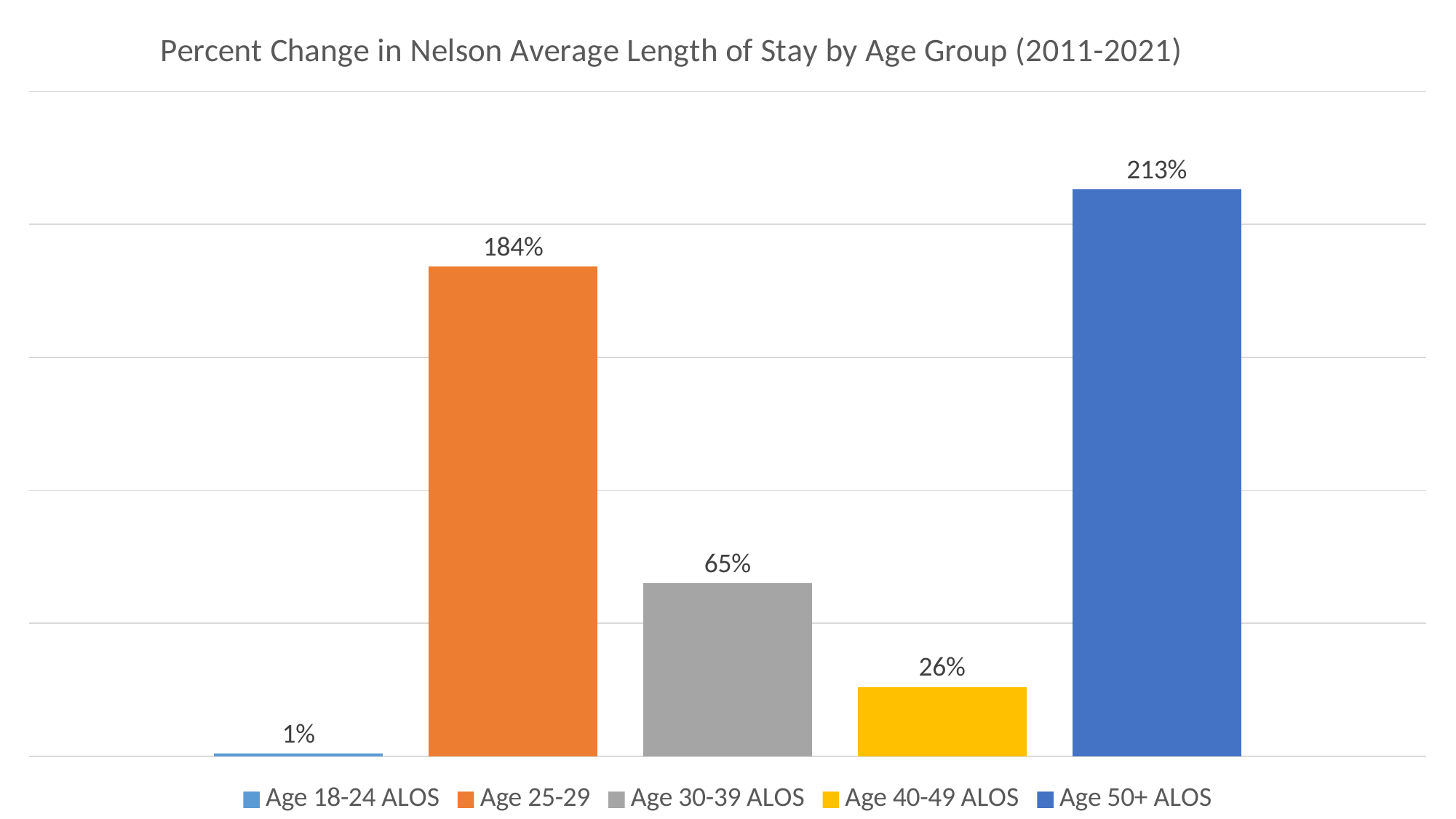
What is the title of the chart? Percent Change in Nelson Average Length of Stay by Age Group (2011-2021) How many age groups are shown in the chart? 5 What is the difference between the percent change for Age 30-39 ALOS and Age 40-49 ALOS? 39% What is the percent change in average length of stay for Age 25-29? 184% What is the difference between the percent change for Age 50+ ALOS and Age 25-29? 29% What is the percent change in average length of stay for Age 50+ ALOS? 213% Which has a larger percent change, Age 30-39 ALOS or Age 40-49 ALOS? Age 30-39 ALOS What is the percent change in average length of stay for Age 30-39 ALOS? 65% Which age group has the highest percent change in average length of stay? Age 50+ ALOS What is the percent change in average length of stay for Age 18-24 ALOS? 1% What kind of chart is shown on the slide? Bar chart Which age group has the lowest percent change in average length of stay? Age 18-24 ALOS